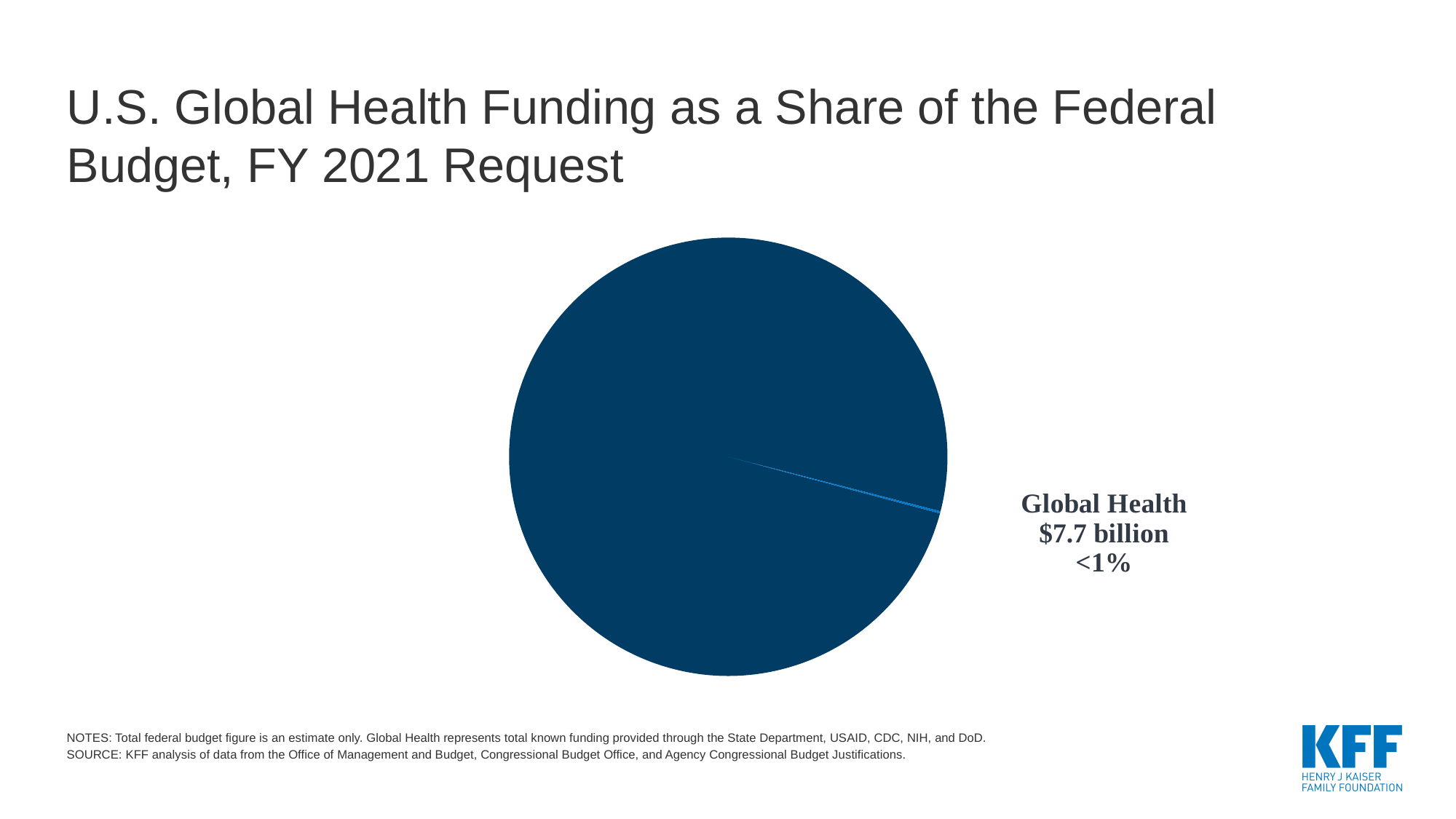
What kind of chart is shown on the slide? pie chart What dollar amount is shown for Global Health? $7.7 billion What is the title of the chart? U.S. Global Health Funding as a Share of the Federal Budget, FY 2021 Request Which fiscal year request does the chart refer to? FY 2021 How many slices of the pie are labeled? 1 What colour is the large slice of the pie? dark blue Is the Global Health slice larger or smaller than the rest of the pie? smaller What share of the federal budget does the Global Health slice represent? <1% Is the Global Health share of the federal budget greater or less than 1%? less